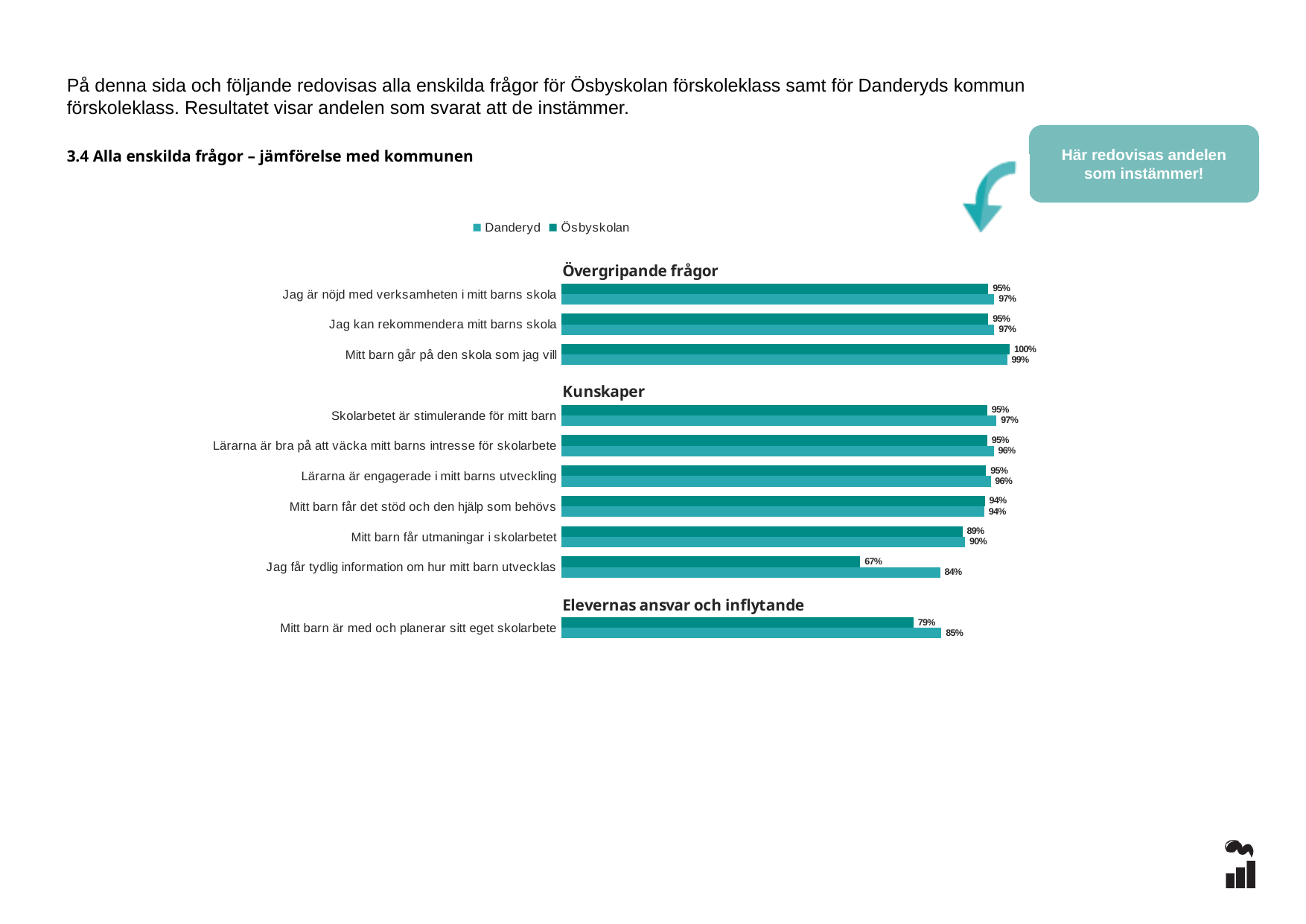
What is the Danderyd value for 'Mitt barn är med och planerar sitt eget skolarbete'? 85% What is the Ösbyskolan value for 'Jag får tydlig information om hur mitt barn utvecklas'? 67% Which question has the highest Ösbyskolan value? Mitt barn går på den skola som jag vill What is the Danderyd value for 'Jag får tydlig information om hur mitt barn utvecklas'? 84% Which question has the lowest Ösbyskolan value? Jag får tydlig information om hur mitt barn utvecklas Which two series are listed in the chart legend? Danderyd and Ösbyskolan What is the difference between the Danderyd and Ösbyskolan values for 'Jag får tydlig information om hur mitt barn utvecklas'? 17 percentage points For 'Mitt barn är med och planerar sitt eget skolarbete', which is larger: the Danderyd value or the Ösbyskolan value? Danderyd How many series does the chart legend list? 2 What kind of chart is shown on the slide? Bar chart What is the Ösbyskolan value for 'Mitt barn går på den skola som jag vill'? 100% How many questions (categories) are plotted in the chart? 10